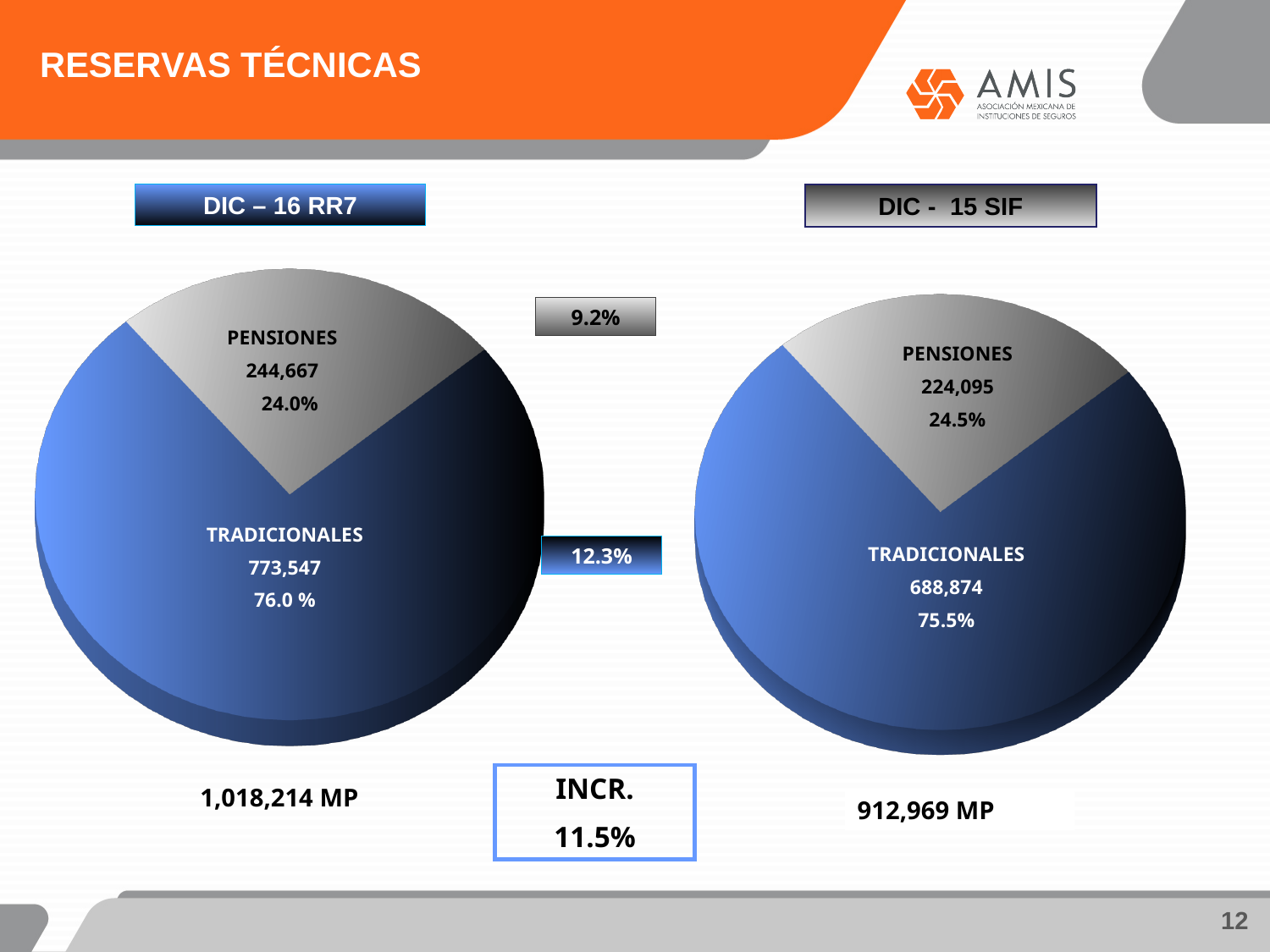
How many slices does the DIC – 16 RR7 pie chart on the left have? 2 In the DIC - 15 SIF pie chart on the right, what share of the pie does TRADICIONALES represent? 75.5% In the DIC - 15 SIF pie chart on the right, which slice is the smallest? PENSIONES In the DIC – 16 RR7 pie chart on the left, which slice is the largest? TRADICIONALES What type of chart is used on this slide? Pie chart Which is larger: the PENSIONES value in the DIC – 16 RR7 chart or the PENSIONES value in the DIC - 15 SIF chart? DIC – 16 RR7 What is the difference between the TRADICIONALES value in the DIC – 16 RR7 chart and the TRADICIONALES value in the DIC - 15 SIF chart? 84,673 In the DIC – 16 RR7 pie chart on the left, what is the value for PENSIONES? 244,667 In the DIC – 16 RR7 pie chart on the left, what is the value for TRADICIONALES? 773,547 In the DIC – 16 RR7 pie chart on the left, what share of the pie does PENSIONES represent? 24.0% In the DIC - 15 SIF pie chart on the right, what is the value for TRADICIONALES? 688,874 In the DIC - 15 SIF pie chart on the right, what is the value for PENSIONES? 224,095